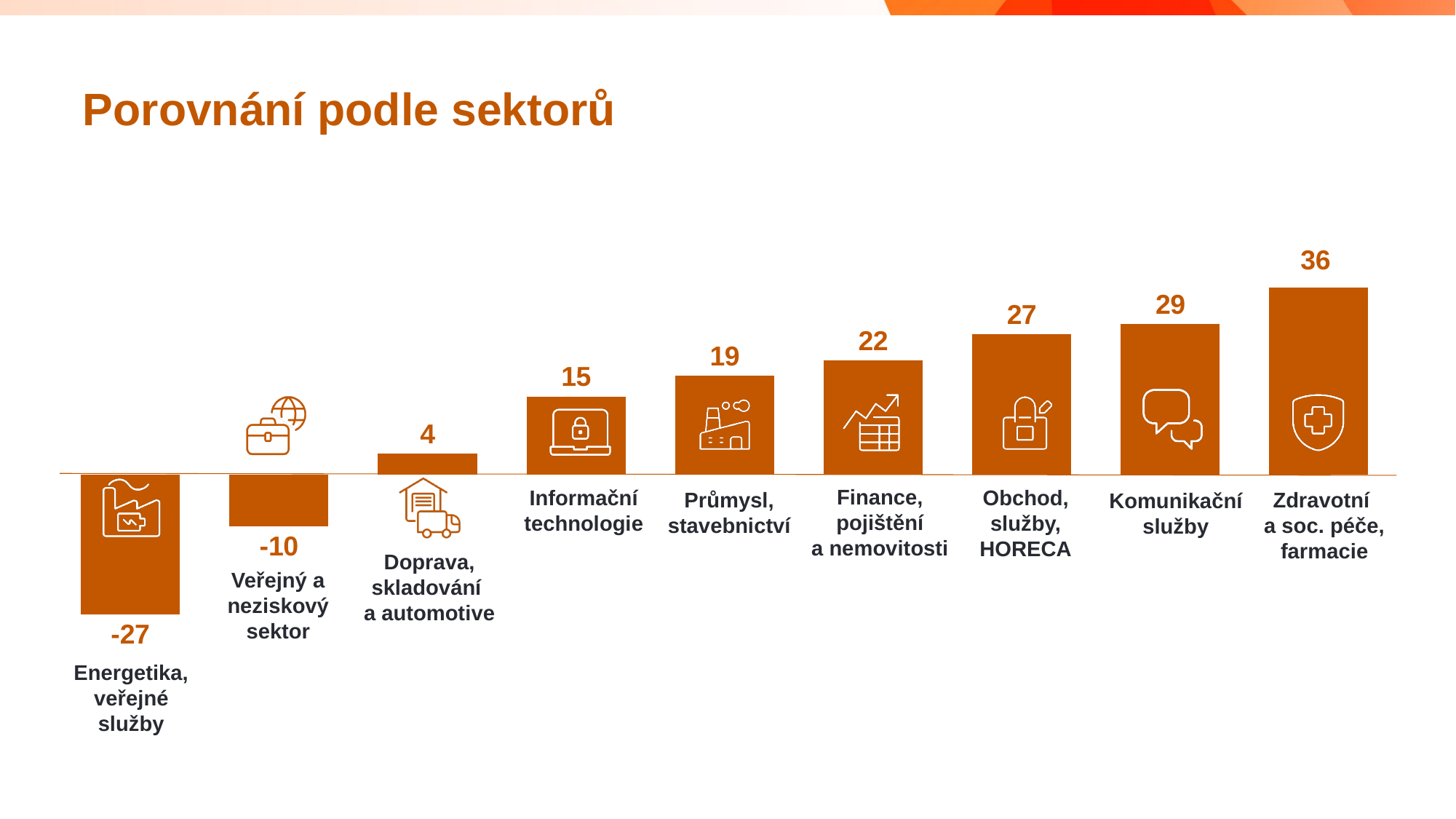
What is the value for Zdravotní a soc. péče, farmacie? 36 Which sector has the lowest value? Energetika, veřejné služby What kind of chart is shown on the slide? Bar chart What is the value for Finance, pojištění a nemovitosti? 22 What is the value for Energetika, veřejné služby? -27 Do the values rise or fall from left to right across the chart? Rise What is the value for Doprava, skladování a automotive? 4 Which is larger, the value for Průmysl, stavebnictví or the value for Finance, pojištění a nemovitosti? Finance, pojištění a nemovitosti Which sector has the highest value? Zdravotní a soc. péče, farmacie What is the difference between the values for Komunikační služby and Informační technologie? 14 What is the difference between the values for Obchod, služby, HORECA and Veřejný a neziskový sektor? 37 How many sectors are shown in the chart? 9